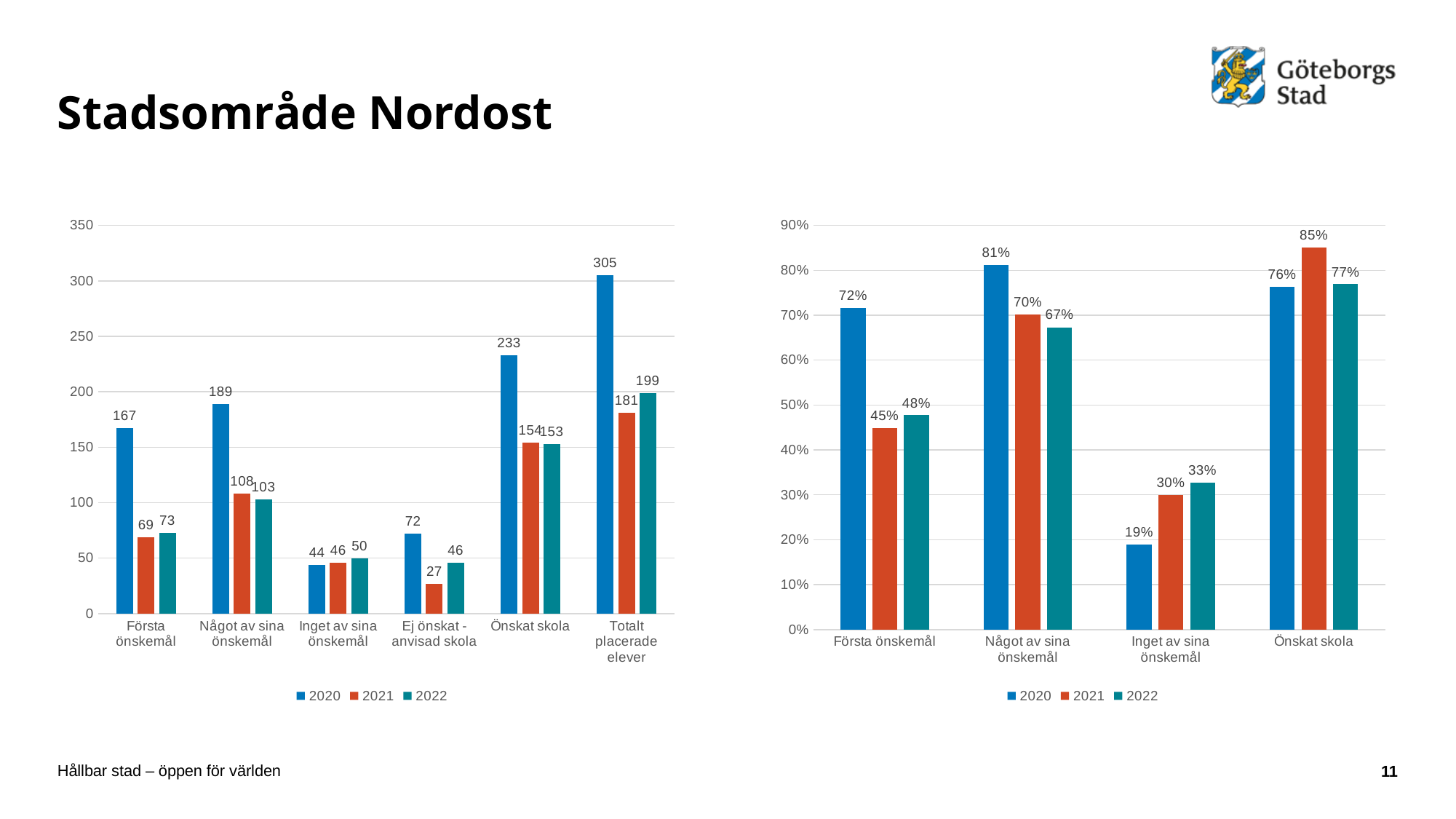
In the right chart, what is the difference between the 2020 and 2021 values for 'Första önskemål'? 27% How many categories are shown on the x axis of the left chart? 6 In the left chart, which category has the lowest value for 2021? Ej önskat - anvisad skola In the right chart, do the values for 'Inget av sina önskemål' rise or fall from 2020 to 2022? Rise What type of chart is the right chart? Bar chart In the right chart, which year has the highest value in the category 'Önskat skola'? 2021 In the left chart, what is the value for 2020 in the category 'Totalt placerade elever'? 305 In the left chart, what is the difference between the 2020 and 2022 values for 'Första önskemål'? 94 How many series does the legend of the right chart list? 3 In the left chart, which is larger for 'Inget av sina önskemål': the 2020 value or the 2022 value? 2022 In the left chart, what is the value for 2021 in the category 'Ej önskat - anvisad skola'? 27 In the right chart, what is the value for 2022 in the category 'Inget av sina önskemål'? 33%